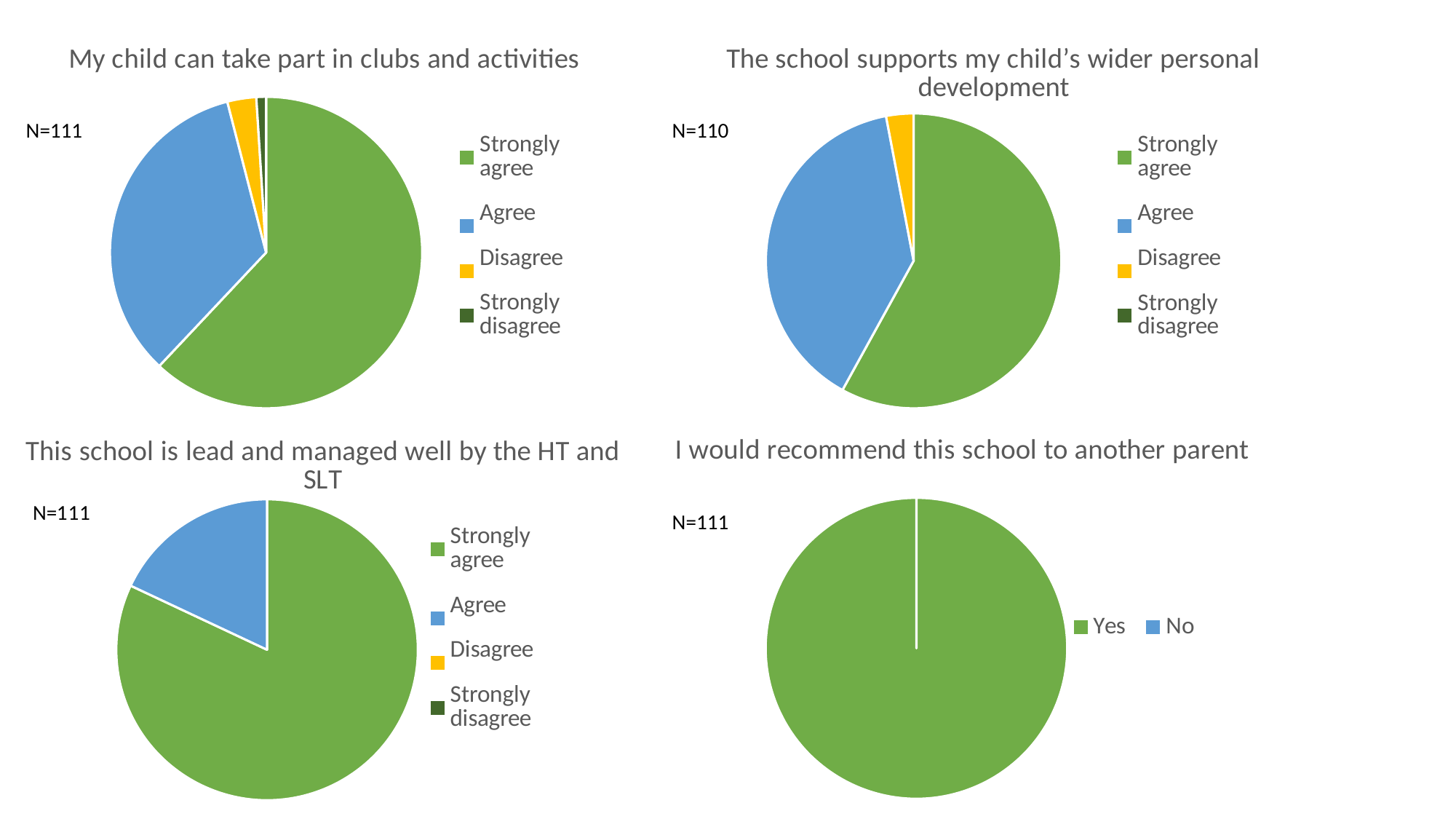
In the chart "The school supports my child's wider personal development", which response has the largest slice? Strongly agree In the chart "The school supports my child's wider personal development", which slice is larger: Agree or Disagree? Agree In the chart "My child can take part in clubs and activities", which response has the largest slice? Strongly agree How many pie charts are shown on the slide? 4 How many entries does the legend list for the chart "My child can take part in clubs and activities"? 4 What is the N value shown for the chart "The school supports my child's wider personal development"? N=110 In the chart "I would recommend this school to another parent", which response has the largest slice? Yes In the chart "My child can take part in clubs and activities", which response has the smallest slice? Strongly disagree In the chart "This school is lead and managed well by the HT and SLT", which slice is larger: Strongly agree or Agree? Strongly agree How many entries does the legend list for the chart "I would recommend this school to another parent"? 2 What type of chart is used for "My child can take part in clubs and activities"? Pie chart